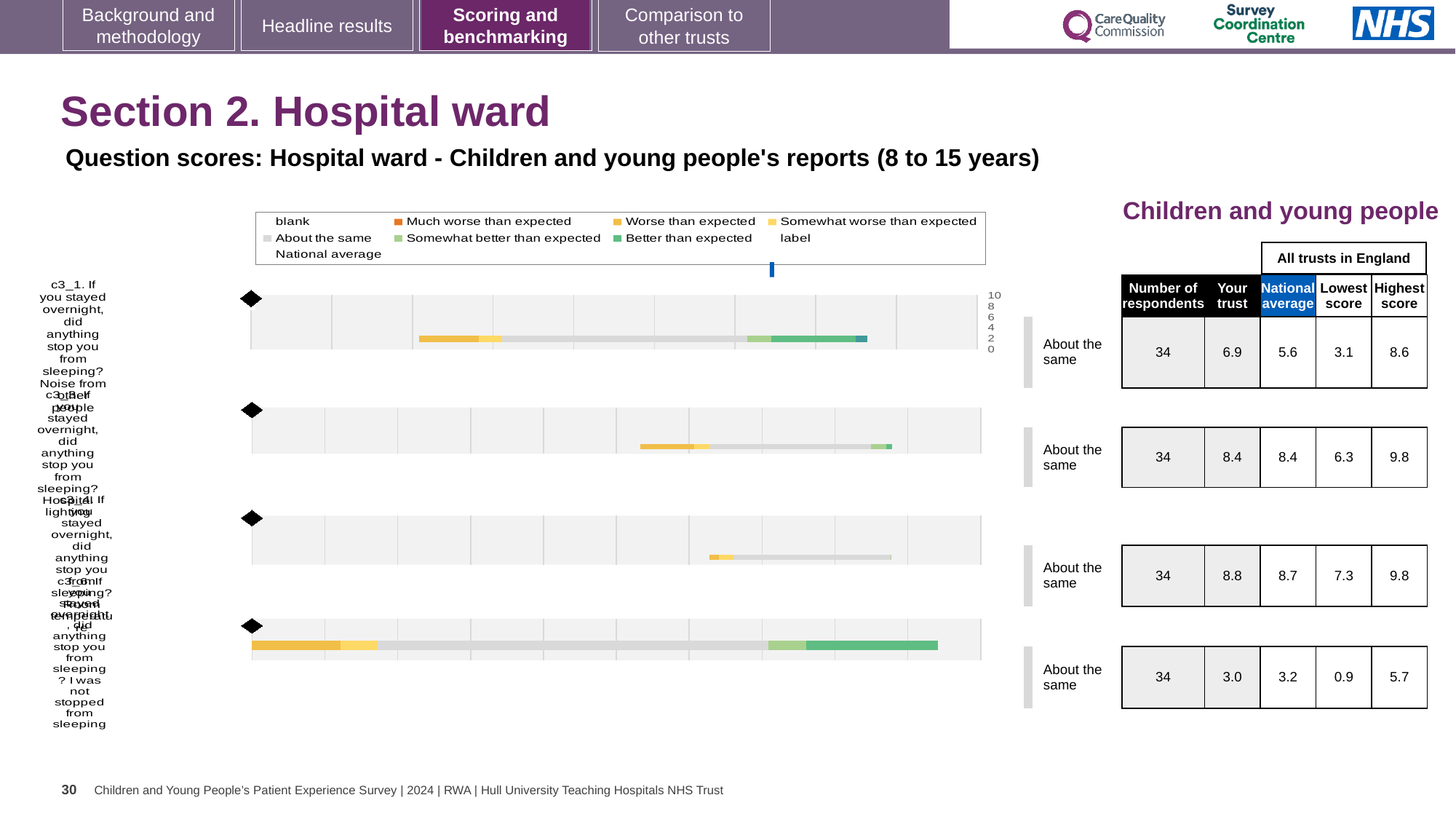
What is the highest value shown on the axis of the top bar chart? 10 Which question row has the lowest 'Your trust' score in the table? the fourth (bottom) row In the legend, which colour represents 'Better than expected'? green What kind of chart is used for the question scores on this slide? bar chart How many separate bar charts (one per question) are shown on the slide? 4 In the table, what is the 'Lowest score' for the fourth (bottom) question row? 0.9 What benchmark label is shown next to each of the four bar charts? About the same How many respondents are listed for each question row in the table? 34 In the table, what is the 'National average' for the second question row? 8.4 In the table, what is the 'Highest score' for the third question row? 9.8 In the table, what is the 'Your trust' score for the first (top) question row? 6.9 What is the difference between the 'Your trust' score and the 'National average' for the first question row? 1.3